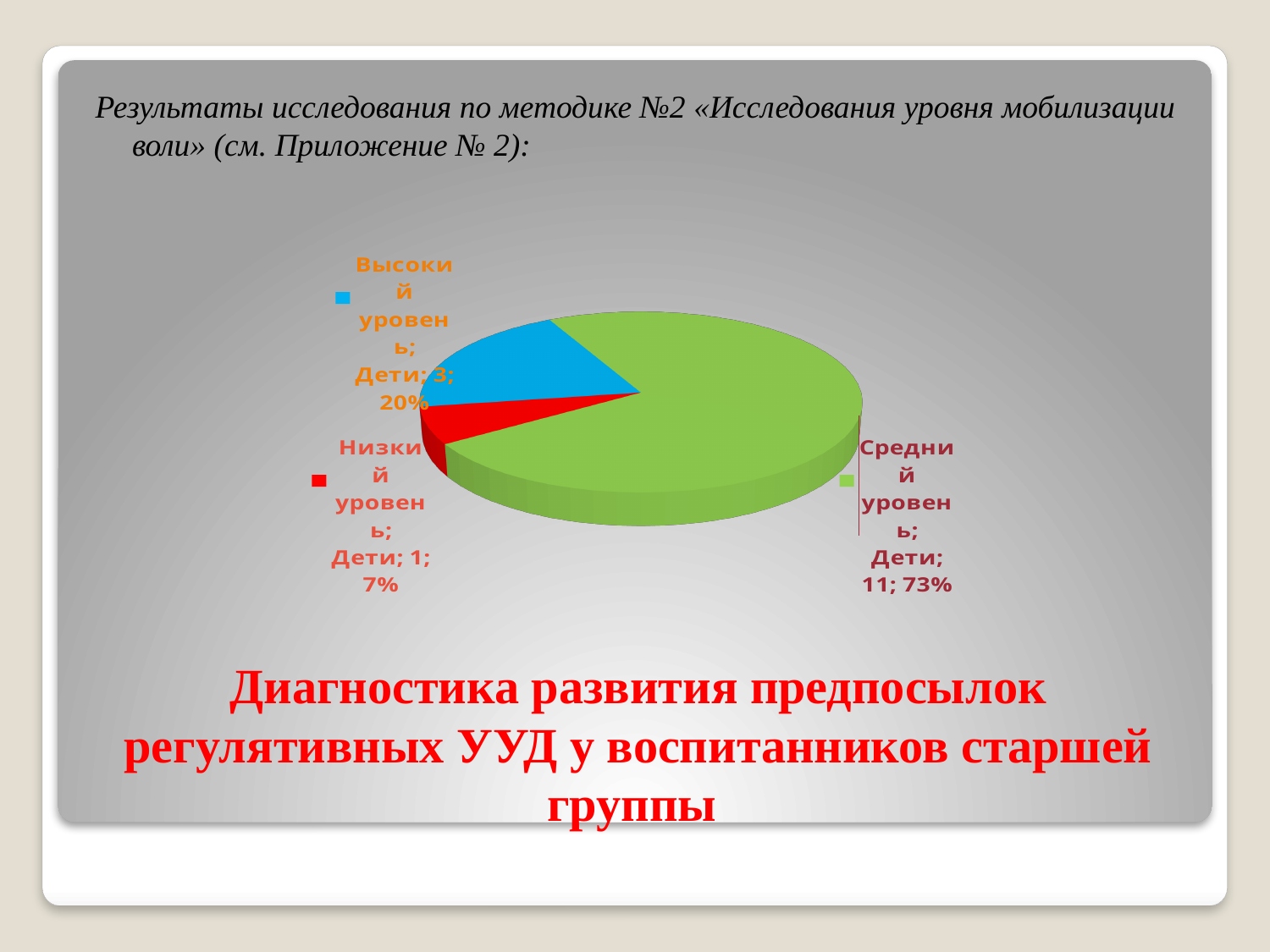
What percentage share does the "Высокий уровень" slice have? 20% What is the total number of children across all slices of the pie? 15 How many children are in the "Средний уровень" slice? 11 How many slices does the pie chart have? 3 What is the difference in number of children between "Средний уровень" and "Высокий уровень"? 8 Which slice is larger: "Высокий уровень" or "Низкий уровень"? Высокий уровень What kind of chart is shown on the slide? pie chart What percentage share does the "Низкий уровень" slice have? 7% What colour is the "Средний уровень" slice? green Which level has the largest slice of the pie? Средний уровень Which level has the smallest slice of the pie? Низкий уровень How many children are in the "Высокий уровень" slice? 3